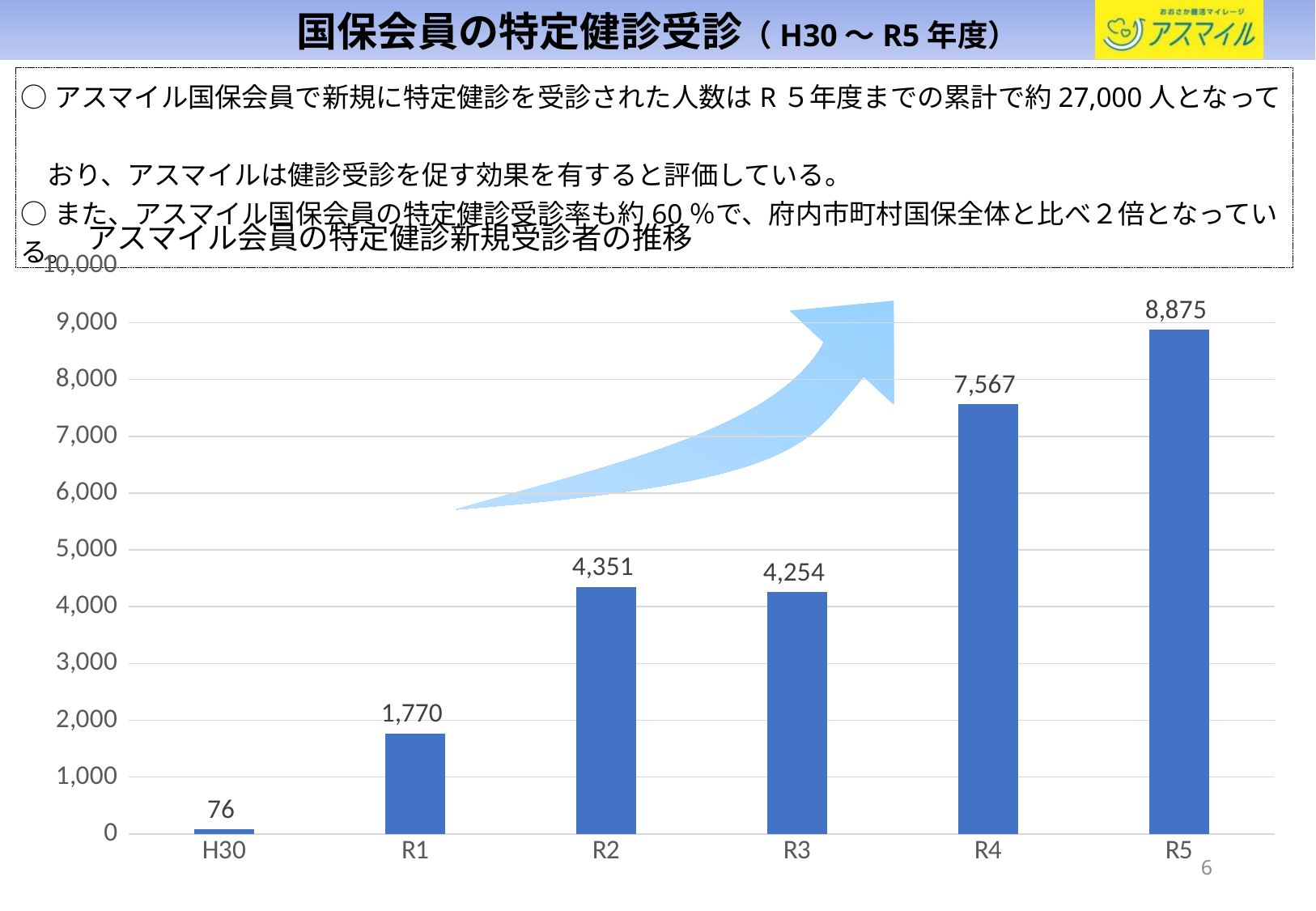
What is the title of the chart? アスマイル会員の特定健診新規受診者の推移 What is the difference between the values for R2 and R3? 97 What is the value for R4? 7,567 What kind of chart is shown on the slide? bar chart Is the value for R4 greater or less than 7,000? greater Which year has the lowest value? H30 What is the value for R2? 4,351 Which year has the highest value? R5 How many years are shown on the x axis? 6 Which is larger, the value for R1 or the value for R3? R3 What is the value for H30? 76 What is the difference between the values for R5 and R4? 1,308